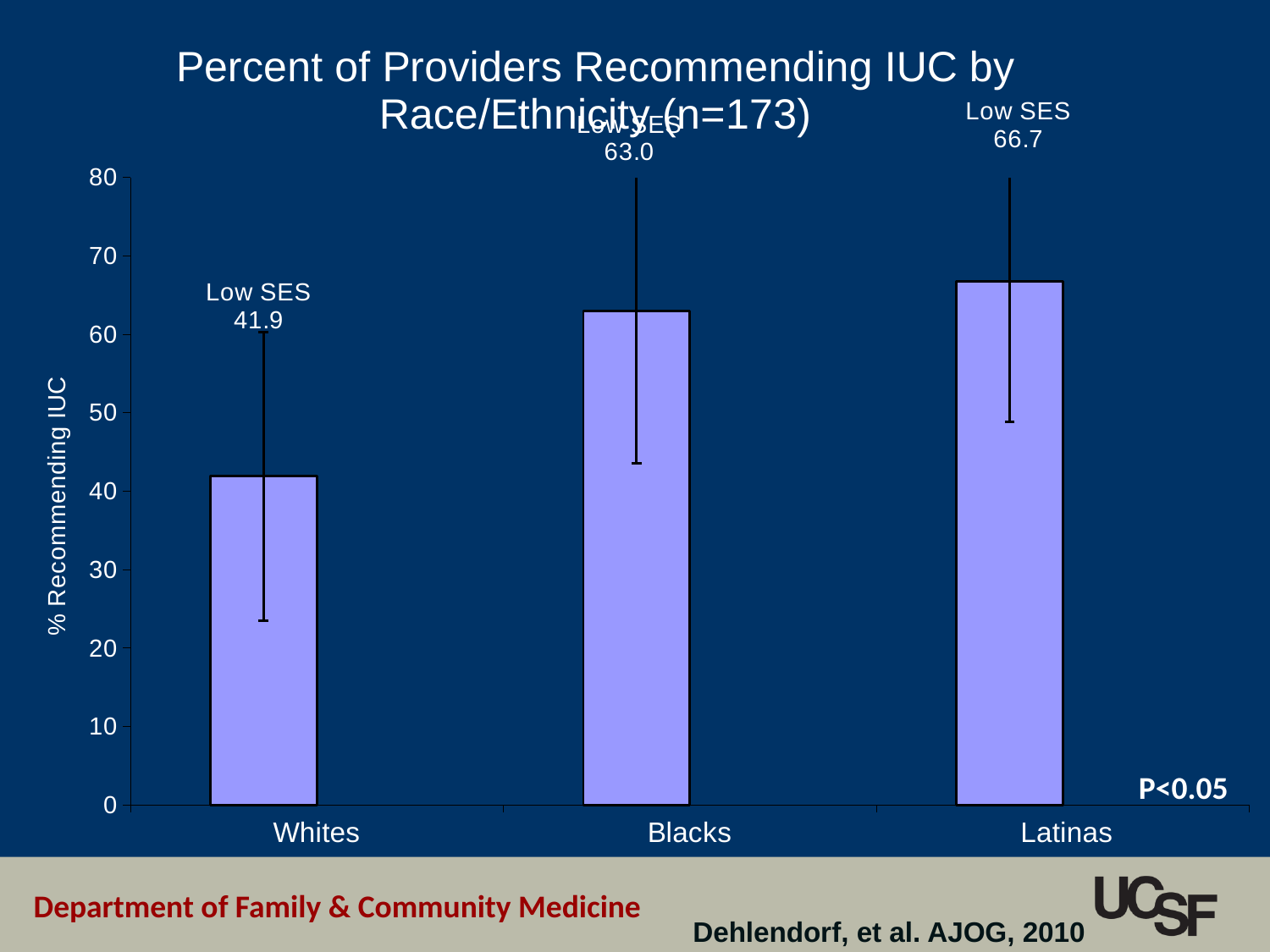
What percent of providers recommended IUC for Latinas? 66.7 What is the label of the y axis? % Recommending IUC What kind of chart is shown on the slide? bar chart What is the difference between the values for Blacks and Whites? 21.1 Which is larger, the value for Blacks or the value for Whites? Blacks What percent of providers recommended IUC for Whites? 41.9 Is the value for Whites greater or less than 50? less Which race/ethnicity group has the highest percent of providers recommending IUC? Latinas What is the difference between the values for Latinas and Whites? 24.8 How many race/ethnicity categories are shown on the x axis? 3 Which race/ethnicity group has the lowest percent of providers recommending IUC? Whites What percent of providers recommended IUC for Blacks? 63.0